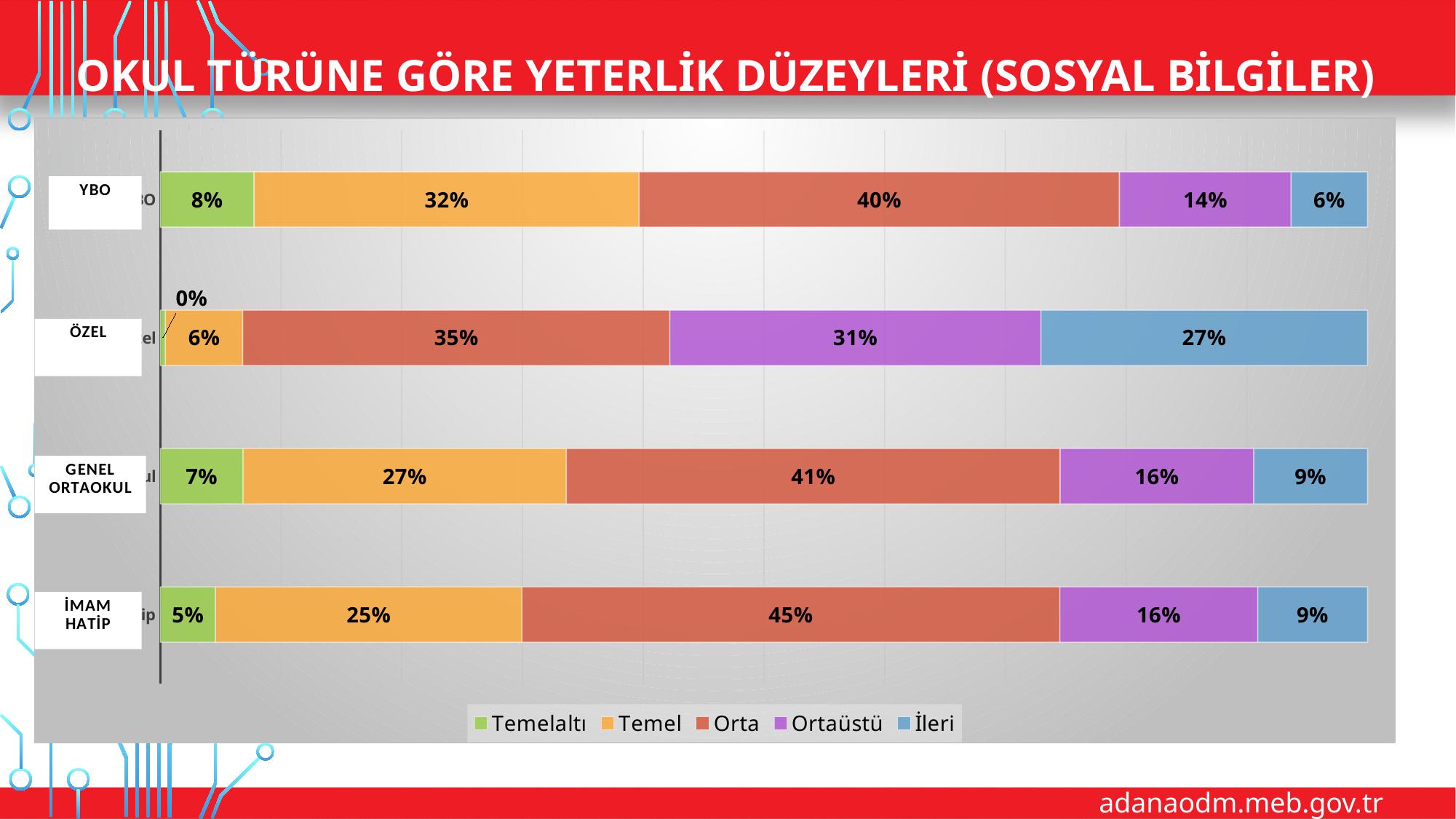
How many series does the legend list? 5 What is the difference between the Ortaüstü values for ÖZEL and YBO? 17% Which is larger, the Temelaltı value for YBO or for GENEL ORTAOKUL? YBO How many school types (categories) are shown in the chart? 4 Which school type has the lowest Temel value? ÖZEL Which school type has the highest Orta value? İMAM HATİP What is the Temelaltı value for ÖZEL? 0% What is the Orta value for YBO? 40% What is the Temel value for İMAM HATİP? 25% What is the İleri value for ÖZEL? 27% What is the total of the stacked bar for GENEL ORTAOKUL? 100% What type of chart is shown on the slide? Stacked bar chart